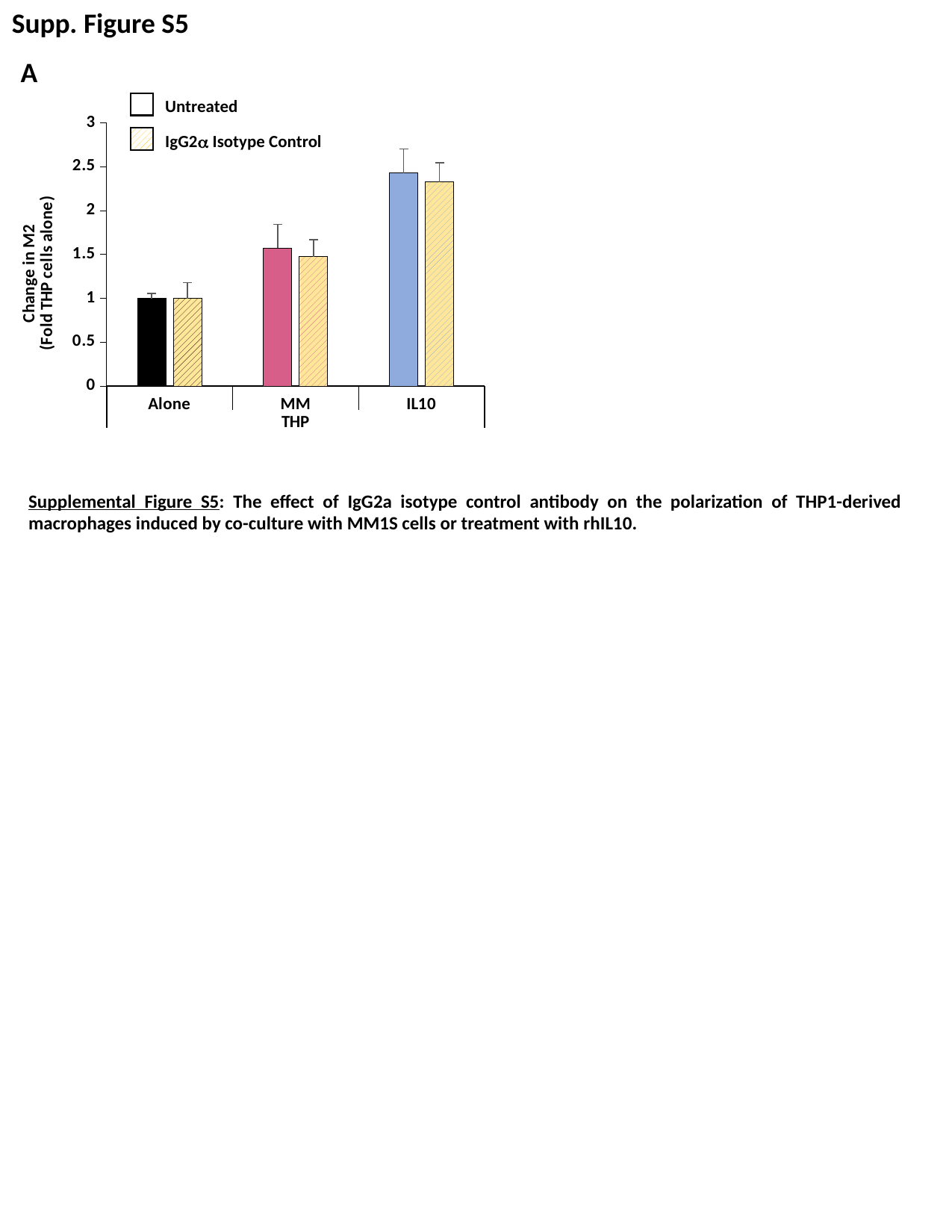
Which category has the highest Untreated value? IL10 What is the label of the y axis? Change in M2 (Fold THP cells alone) Is the IgG2α Isotype Control value for IL10 greater or less than 2.5? less Is the IgG2α Isotype Control value for MM greater or less than 1? greater What kind of chart is shown in panel A? bar chart Is the Untreated value for IL10 greater or less than 2? greater Do the Untreated values rise or fall from Alone to IL10 along the x axis? rise How many categories are shown on the x axis? 3 How many series does the legend list? 2 For the Untreated series, which is larger: MM or IL10? IL10 Which category has the lowest IgG2α Isotype Control value? Alone